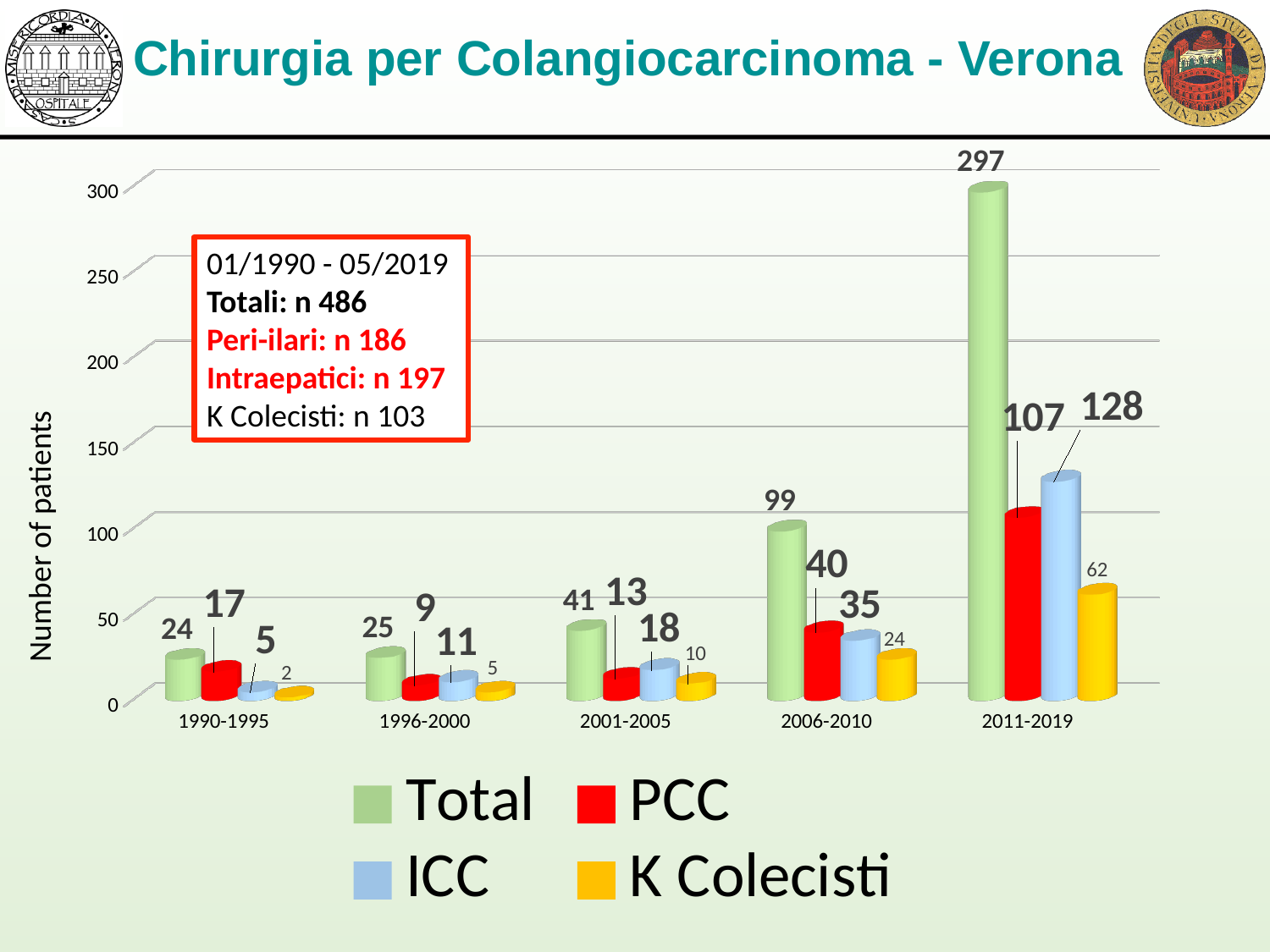
Which period has the lowest K Colecisti value? 1990-1995 What is the ICC value for 2001-2005? 18 How many periods are shown on the x axis? 5 Do the Total values rise or fall from 1990-1995 to 2011-2019? rise What is the K Colecisti value for 1996-2000? 5 What is the Total value for 2011-2019? 297 Which is larger for 2006-2010, PCC or ICC? PCC How many series does the legend list? 4 What is the difference between the ICC and PCC values for 2011-2019? 21 Which period has the highest Total value? 2011-2019 What is the PCC value for 2006-2010? 40 What kind of chart is shown on the slide? bar chart